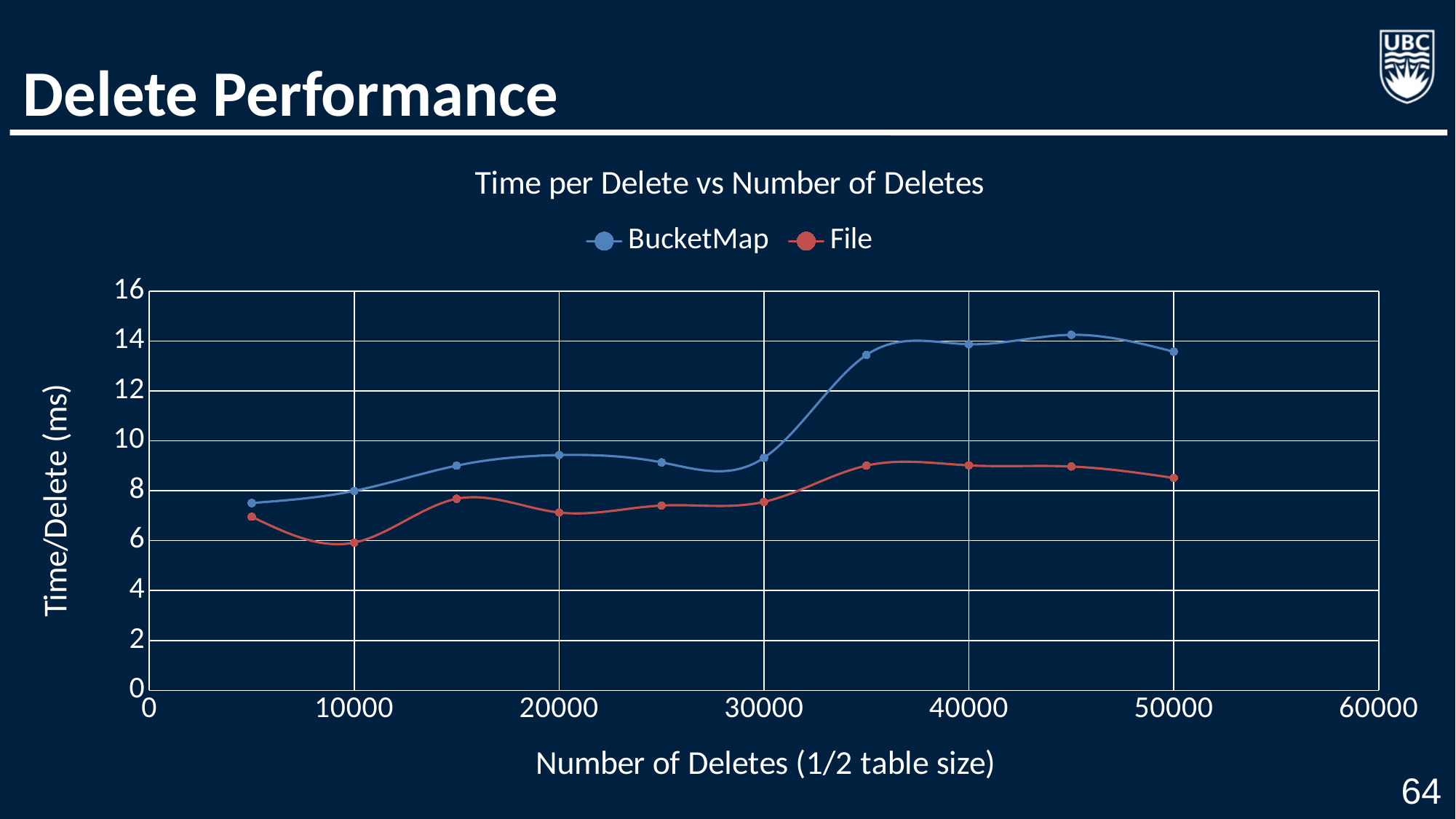
At which number of deletes does the File series reach its lowest time per delete? 10000 What is the title of the chart? Time per Delete vs Number of Deletes Is the BucketMap value at 5000 deletes greater or less than 8 ms? less At 35000 deletes, which series has the higher time per delete, BucketMap or File? BucketMap Does the BucketMap time per delete generally rise or fall as the number of deletes increases from 5000 to 45000? rise Is the File value at 10000 deletes greater or less than 8 ms? less Is the BucketMap value at 35000 deletes greater or less than 12 ms? greater At which number of deletes does the BucketMap series reach its highest time per delete? 45000 What kind of chart is shown on the slide? Line chart How many data points are plotted for the BucketMap series? 10 How many series does the legend list? 2